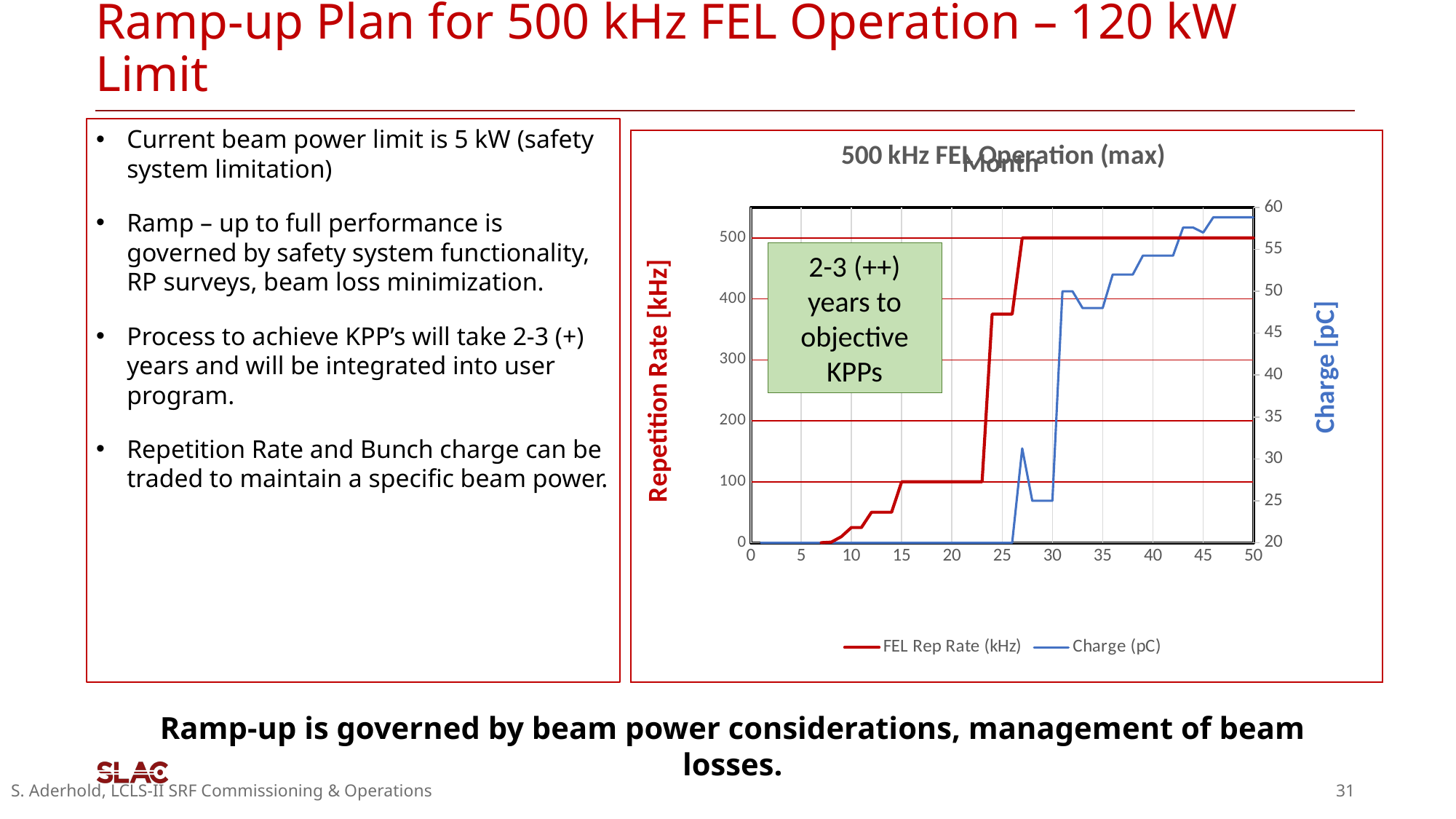
Is the FEL Rep Rate value at month 10 greater or less than 100? less Which is larger, the Charge value at month 30 or at month 40? month 40 Does the FEL Rep Rate series rise or fall as the month increases along the x axis? rises What are the two series named in the chart legend? FEL Rep Rate (kHz) and Charge (pC) How many series does the chart legend list? 2 What kind of chart is shown on the slide? line chart What is the FEL Rep Rate value at month 20? 100 Is the Charge value at month 45 greater or less than 55? greater What is the title of the chart? 500 kHz FEL Operation (max) What is the Charge value at month 20? 20 What is the FEL Rep Rate value at month 40? 500 Is the FEL Rep Rate value at month 25 greater or less than 300? greater